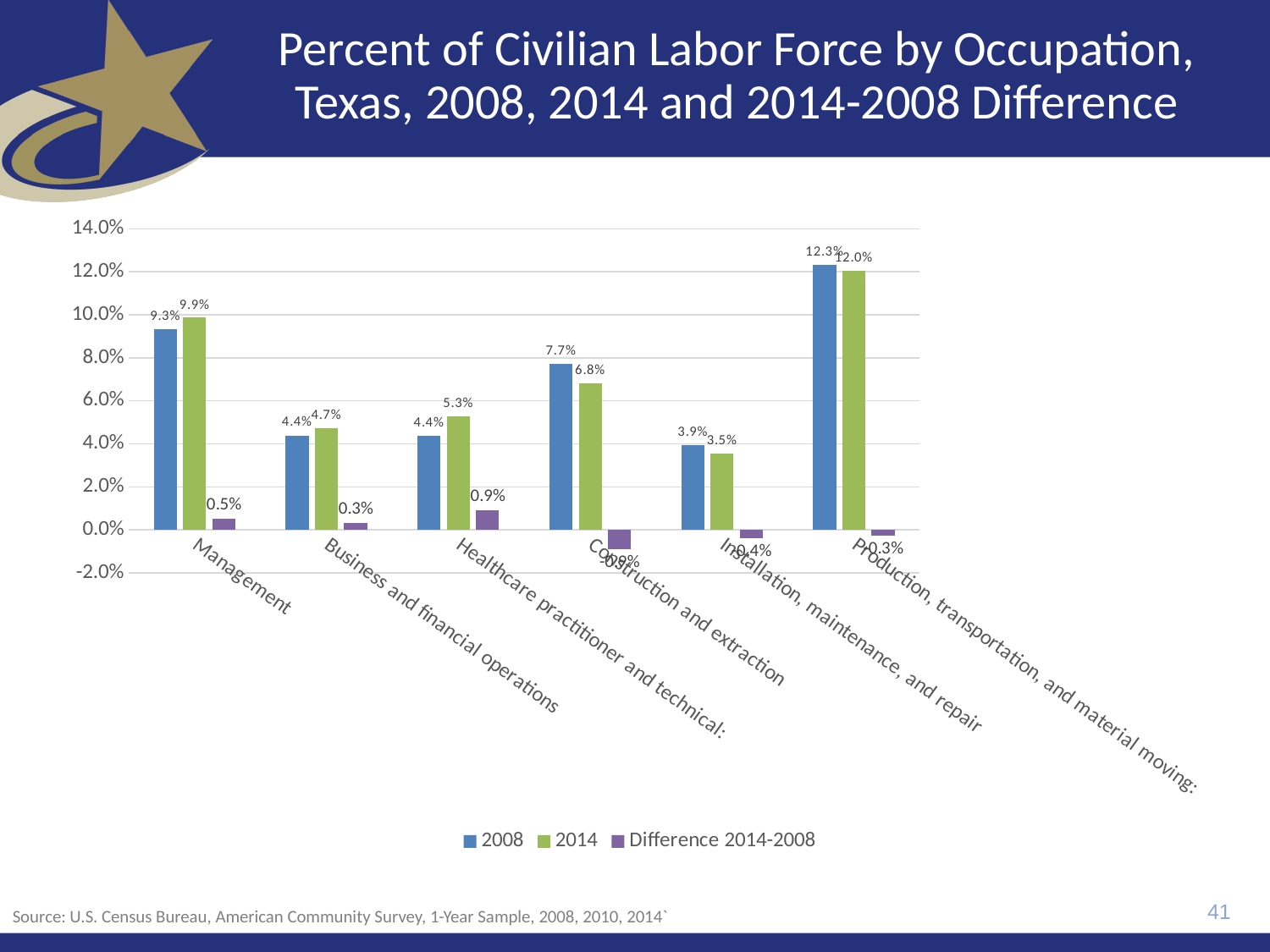
How many occupation categories are shown on the x axis? 6 Which occupation has the highest 2014 value? Production, transportation, and material moving Is the 2008 value for Production, transportation, and material moving greater or less than 10.0%? greater What colour represents the 2014 series in the legend? green What is the 2008 value for Management? 9.3% How much higher is the 2008 value than the 2014 value for Construction and extraction? 0.9% How many series does the legend list? 3 Which is larger: the 2014 value for Business and financial operations or the 2014 value for Healthcare practitioner and technical? Healthcare practitioner and technical What is the 2014 value for Healthcare practitioner and technical? 5.3% What kind of chart is shown on the slide? bar chart Which occupation has the lowest 2008 value? Installation, maintenance, and repair What is the Difference 2014-2008 value for Healthcare practitioner and technical? 0.9%